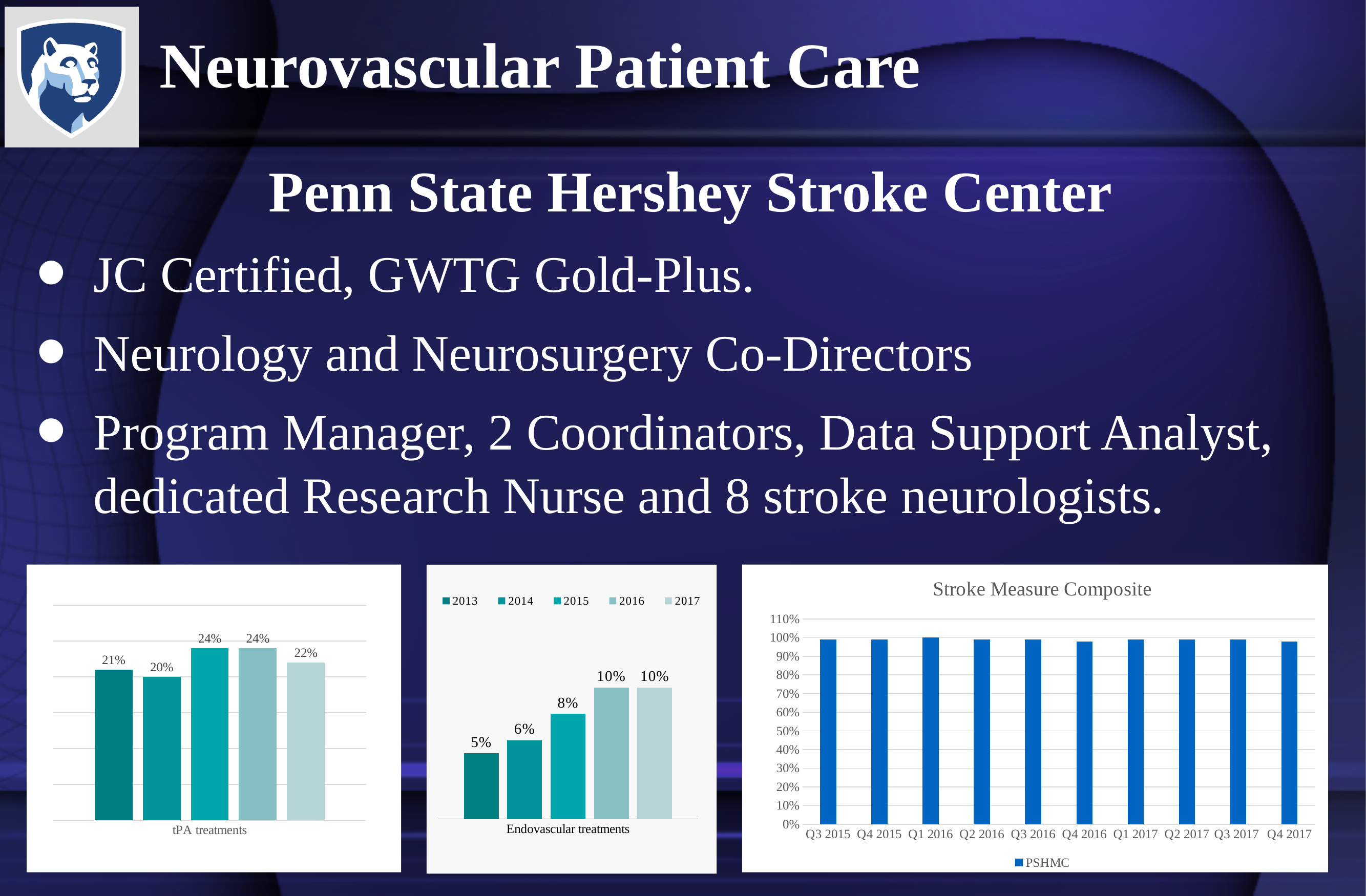
In the Stroke Measure Composite chart, is the value for Q3 2015 greater or less than 90%? greater In the Endovascular treatments chart, what is the value for 2015? 8% In the Endovascular treatments chart, which year has the lowest value? 2013 In the tPA treatments chart, what is the value of the last (rightmost) bar? 22% In the Endovascular treatments chart, what is the value for 2013? 5% In the Endovascular treatments chart, what is the value for 2017? 10% In the tPA treatments chart, what is the value of the first (leftmost) bar? 21% In the Endovascular treatments chart, what is the difference between the 2016 and 2013 values? 5% In the Endovascular treatments chart, how many series does the legend list? 5 In the Stroke Measure Composite chart, how many quarters are shown on the x axis? 10 In the tPA treatments chart, how many bars are plotted? 5 In the Endovascular treatments chart, do the values rise or fall from 2013 to 2017? rise